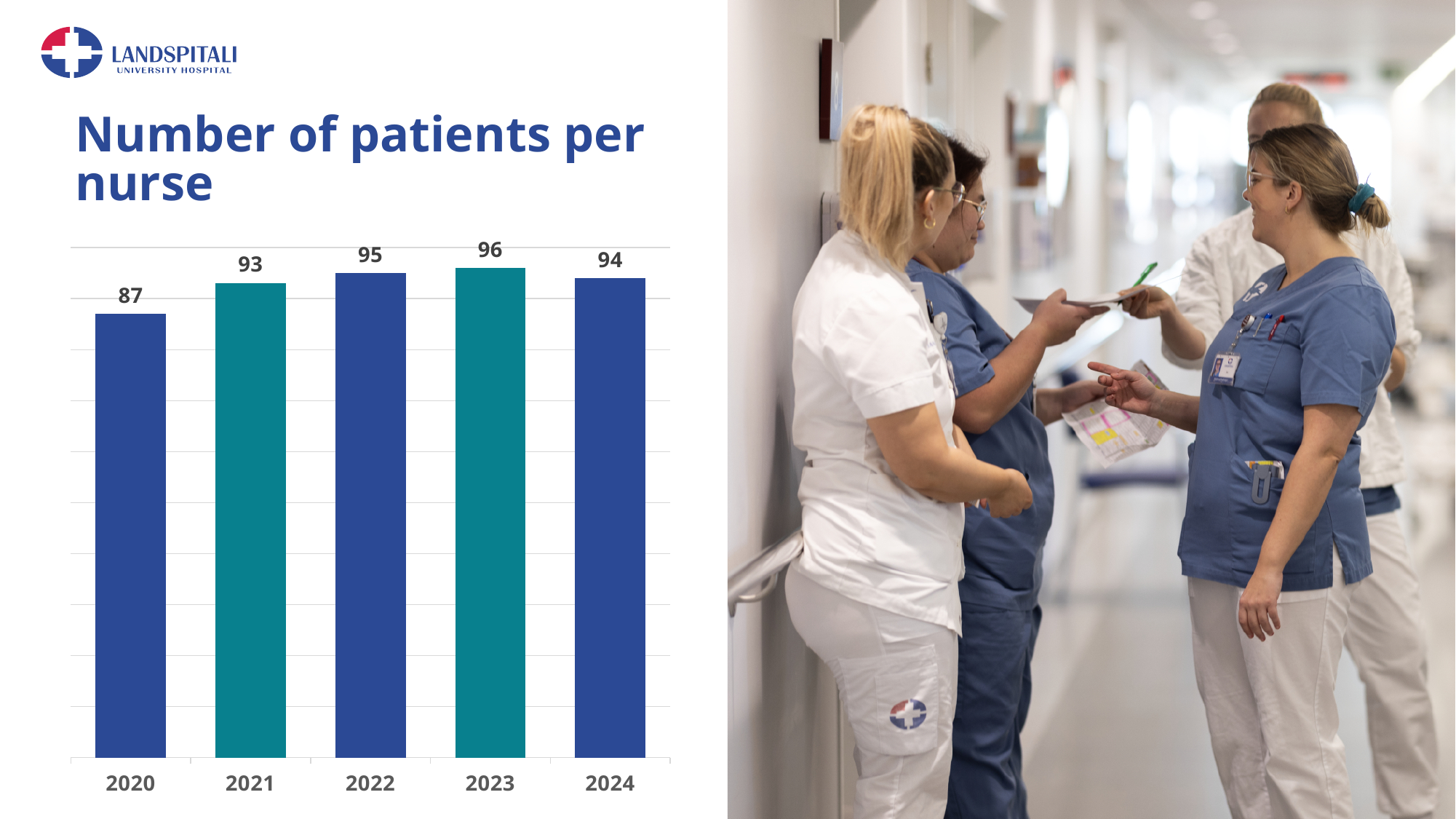
Which year has a larger value, 2021 or 2024? 2024 What is the difference between the values for 2022 and 2021? 2 What is the title of the chart? Number of patients per nurse What kind of chart is shown on the slide? Bar chart Does the number of patients per nurse rise or fall from 2020 to 2023? Rise What is the difference between the values for 2023 and 2020? 9 What is the number of patients per nurse in 2020? 87 Which year has the highest number of patients per nurse? 2023 How many years are shown on the chart? 5 Which year has the lowest number of patients per nurse? 2020 What is the number of patients per nurse in 2023? 96 What is the number of patients per nurse in 2024? 94